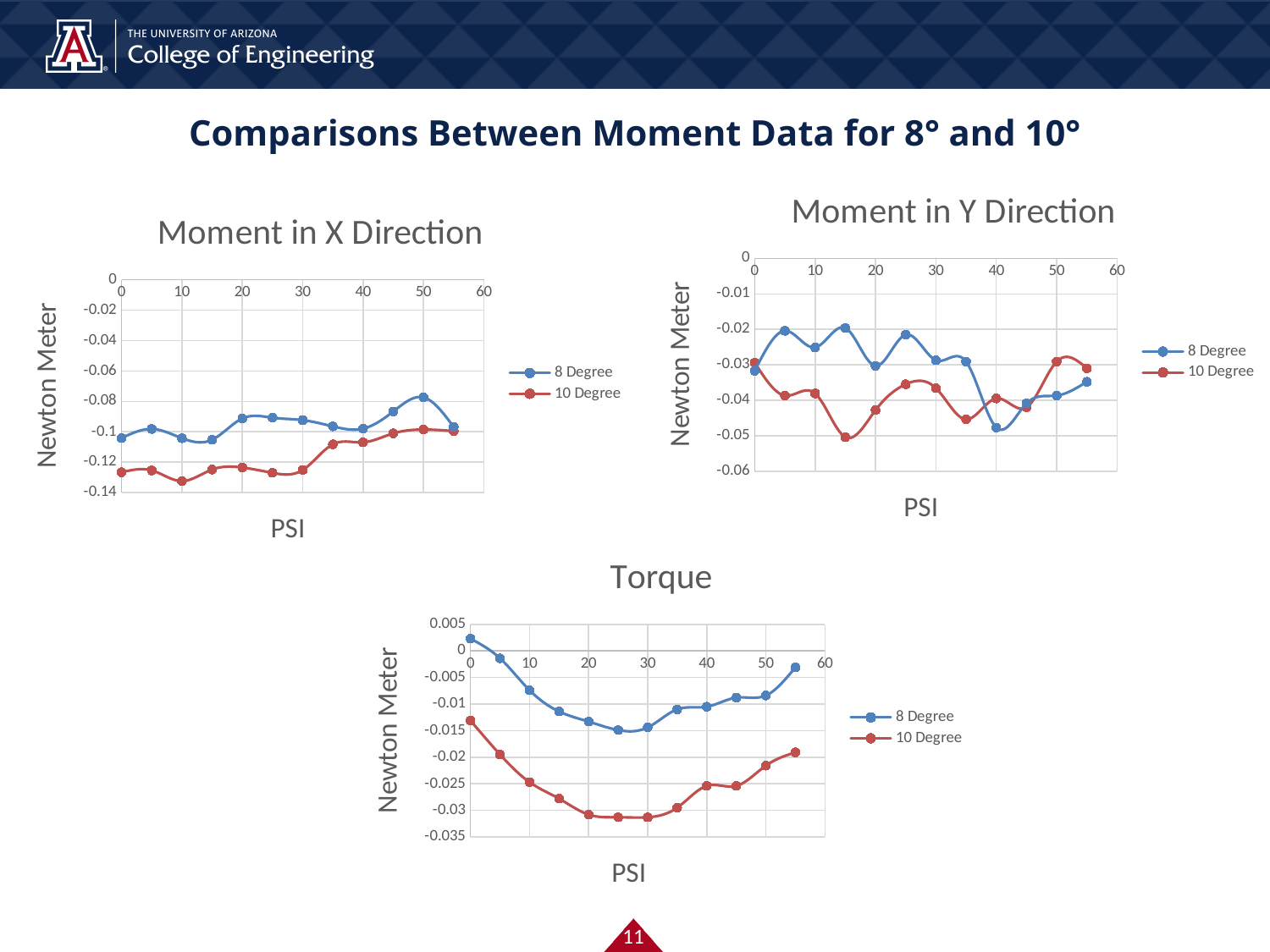
In the "Torque" chart, is the 8 Degree value at 0 PSI greater or less than 0? greater In the "Torque" chart, which series has the larger value at 30 PSI, 8 Degree or 10 Degree? 8 Degree In the "Torque" chart, is the 10 Degree value at 25 PSI greater or less than -0.03? less What is the label of the vertical axis on the "Torque" chart? Newton Meter How many data points does the 8 Degree series have in the "Torque" chart? 12 How many series does the legend of the "Torque" chart list? 2 In the "Moment in X Direction" chart, is the 8 Degree value at 50 PSI greater or less than -0.08? greater What type of chart is the "Moment in X Direction" chart? Line chart In the "Moment in Y Direction" chart, at which PSI value is the 8 Degree series lowest? 40 In the "Moment in Y Direction" chart, which series has the larger value at 15 PSI, 8 Degree or 10 Degree? 8 Degree In the "Moment in X Direction" chart, at which PSI value is the 10 Degree series lowest? 10